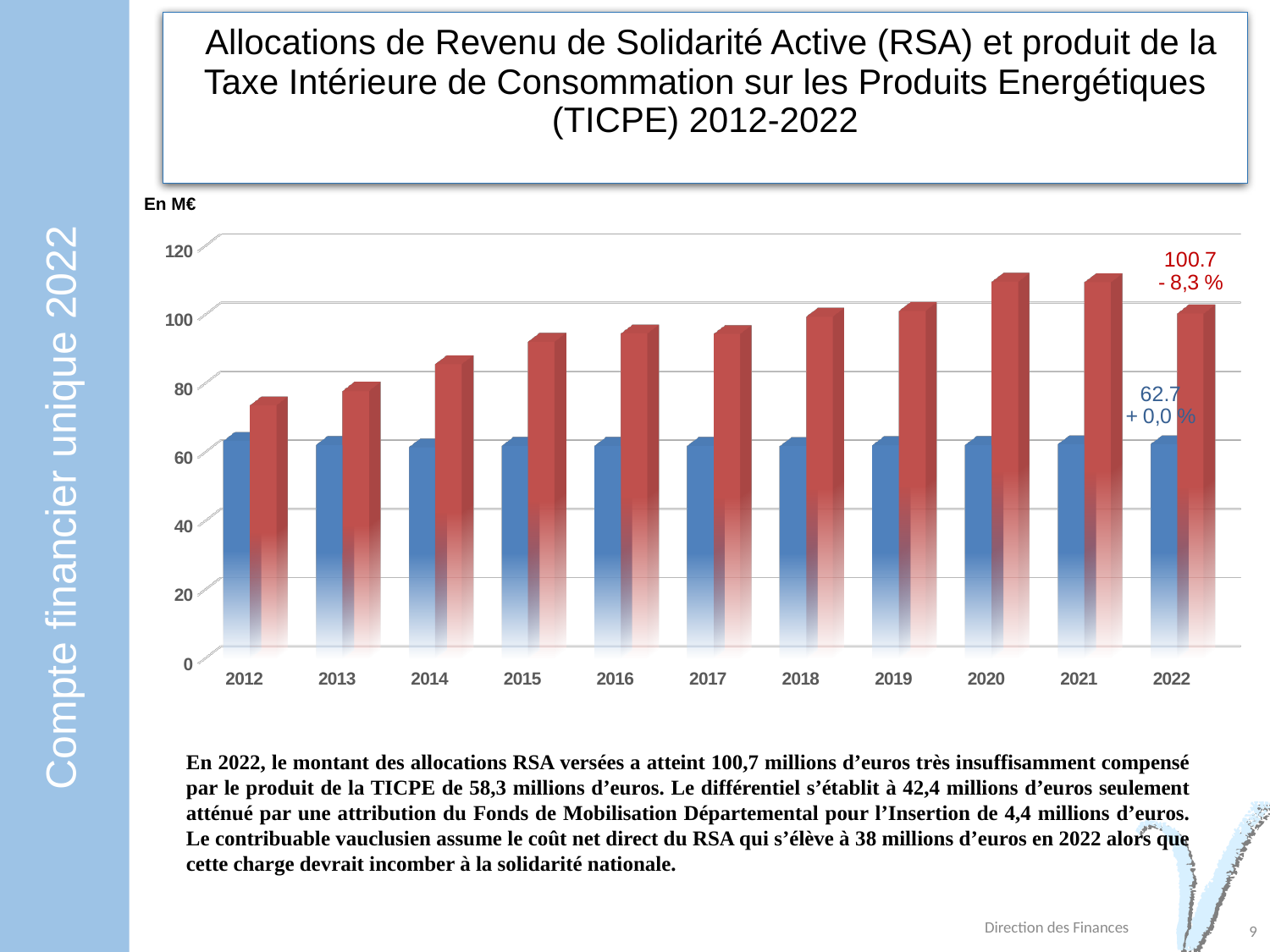
What kind of chart is shown on the slide? Bar chart What value is labelled on the red bar for 2022? 100.7 Do the red bars generally rise or fall from 2012 to 2019? Rise Is the value of the red bar for 2020 greater or less than 100? greater How many years are shown on the x axis? 11 What percentage change is printed next to the red bar for 2022? - 8,3 % In 2016, which bar is larger, the red bar or the blue bar? The red bar What is the difference between the red bar and the blue bar in 2022? 38 What unit is indicated above the chart? En M€ What value is labelled on the blue bar for 2022? 62.7 What percentage change is printed next to the blue bar for 2022? + 0,0 % How many data series are plotted in the chart? 2